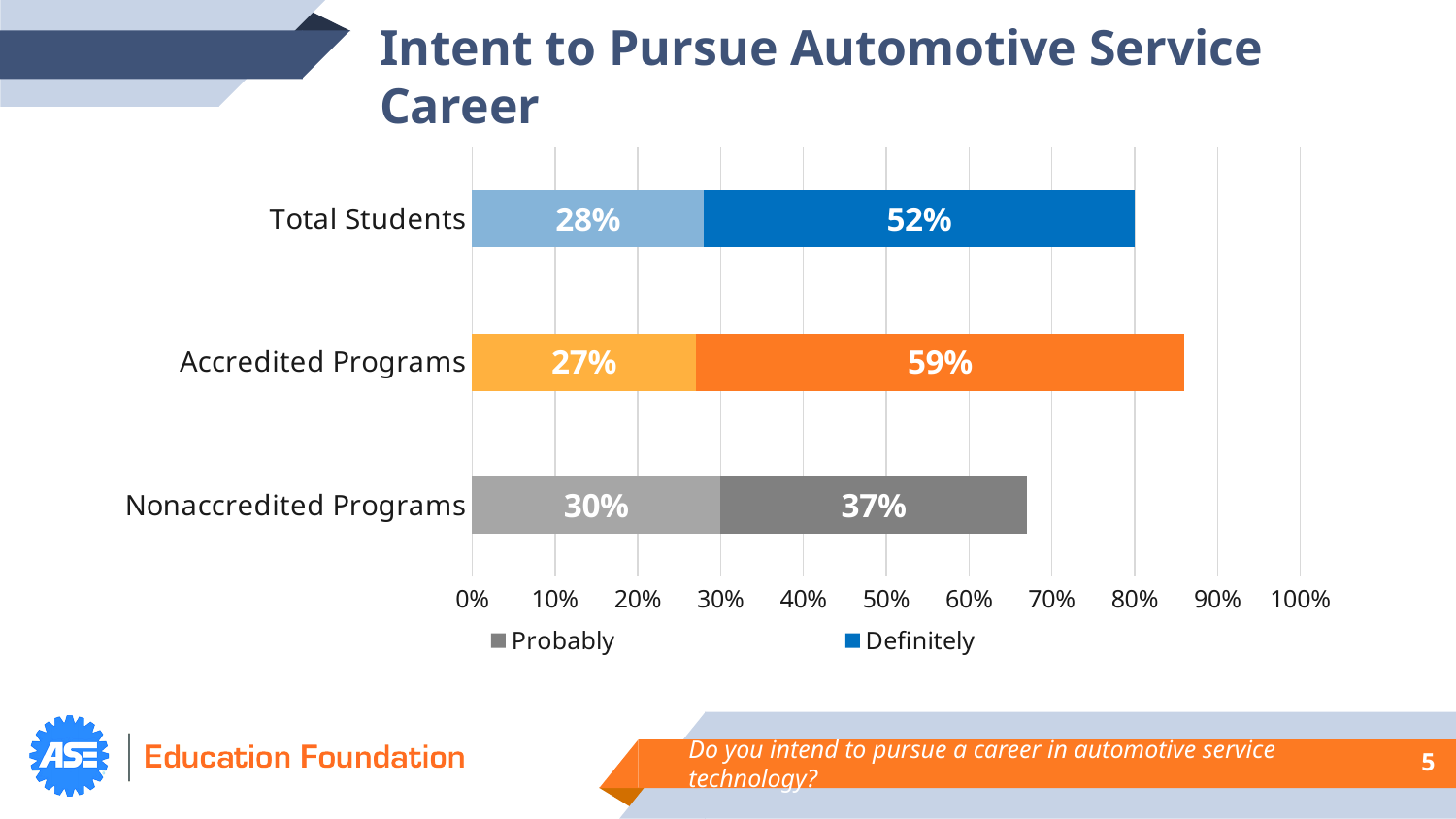
Which is larger: the "Probably" value for Nonaccredited Programs or the "Probably" value for Accredited Programs? Nonaccredited Programs Which category has the highest "Definitely" value? Accredited Programs How many categories are shown on the chart? 3 What is the difference between the "Definitely" values for Accredited Programs and Nonaccredited Programs? 22% What percentage of Total Students said they would "Definitely" pursue an automotive service career? 52% What is the "Probably" value for Nonaccredited Programs? 30% How many series does the legend list? 2 Which category has the lowest "Definitely" value? Nonaccredited Programs What type of chart is shown on the slide? Stacked bar chart What is the "Definitely" value for Accredited Programs? 59% What is the combined total of "Probably" and "Definitely" for Accredited Programs? 86% What is the combined total of "Probably" and "Definitely" for Total Students? 80%